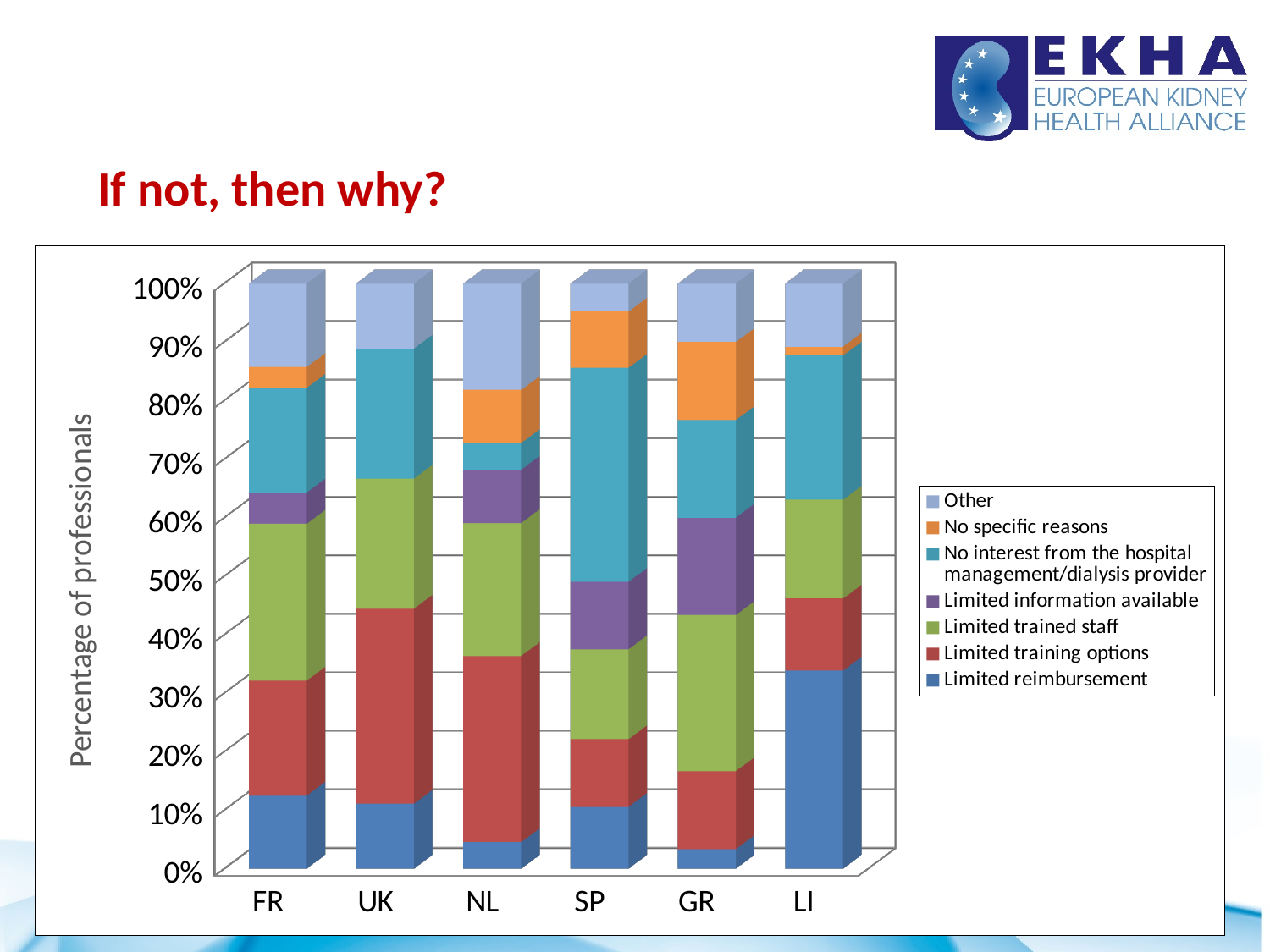
Which is larger, the Limited reimbursement share for LI or for FR? LI How many series does the chart's legend list? 7 Which legend entry is shown in blue at the bottom of each bar? Limited reimbursement Which country has the largest 'No interest from the hospital management/dialysis provider' share? SP Is the 'No interest from the hospital management/dialysis provider' share for SP greater or less than 30%? greater Which country has the largest Limited reimbursement share? LI Is the Limited reimbursement share for FR greater or less than 20%? less Is the Limited reimbursement share for LI greater or less than 20%? greater How many countries are shown along the x axis of the chart? 6 What kind of chart is shown on the slide? Stacked bar chart What is the label of the vertical axis of the chart? Percentage of professionals